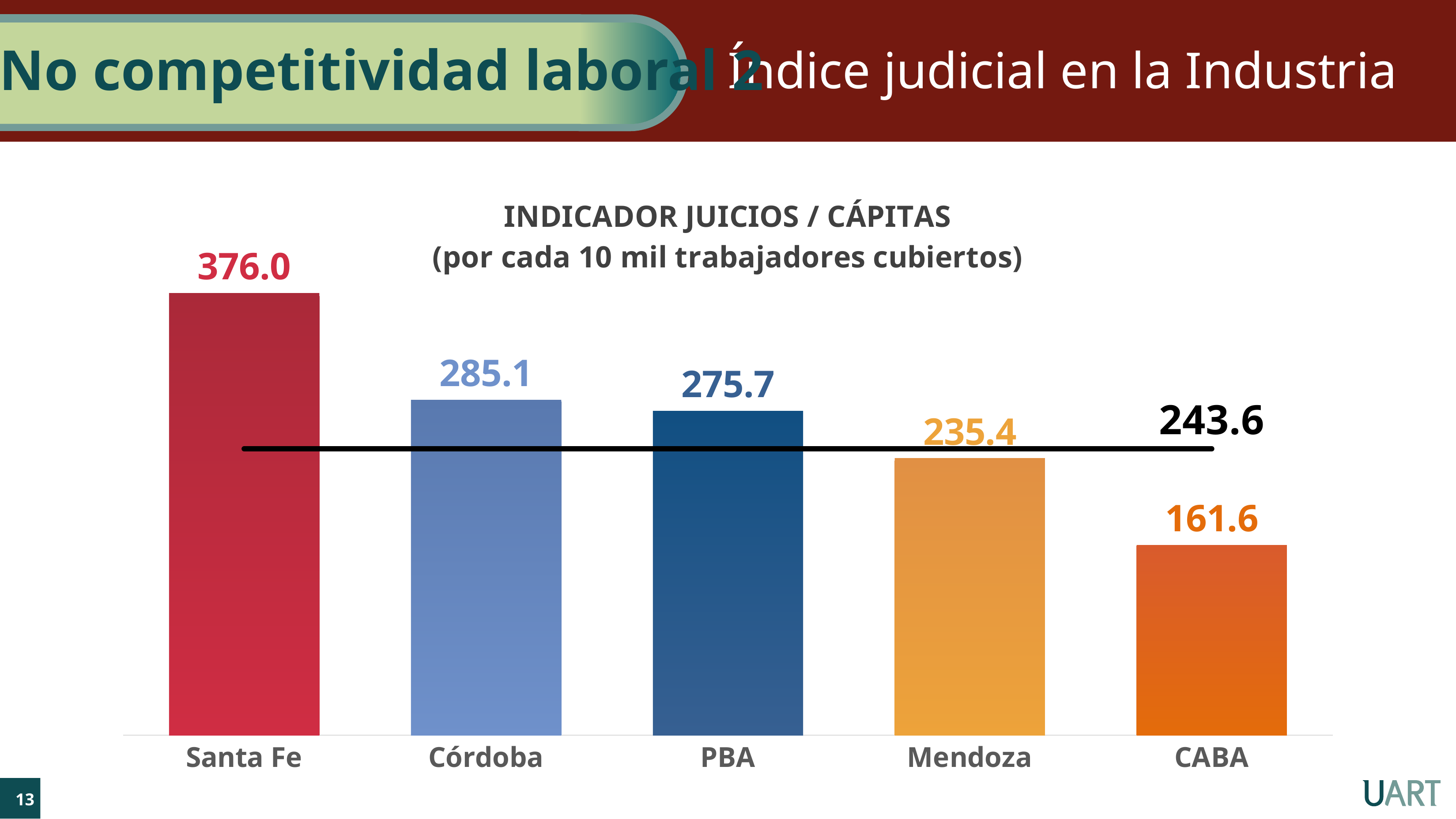
What is the difference between the values for Santa Fe and CABA? 214.4 What is the value for PBA? 275.7 What is the value for Mendoza? 235.4 What kind of chart is shown on the slide? Bar chart Which category has the lowest value? CABA Which is larger, the value for Córdoba or the value for Mendoza? Córdoba What value is labelled on the horizontal reference line across the chart? 243.6 What is the value for Santa Fe? 376.0 What is the value for CABA? 161.6 What is the value for Córdoba? 285.1 How many categories are shown in the chart? 5 Which category has the highest value? Santa Fe